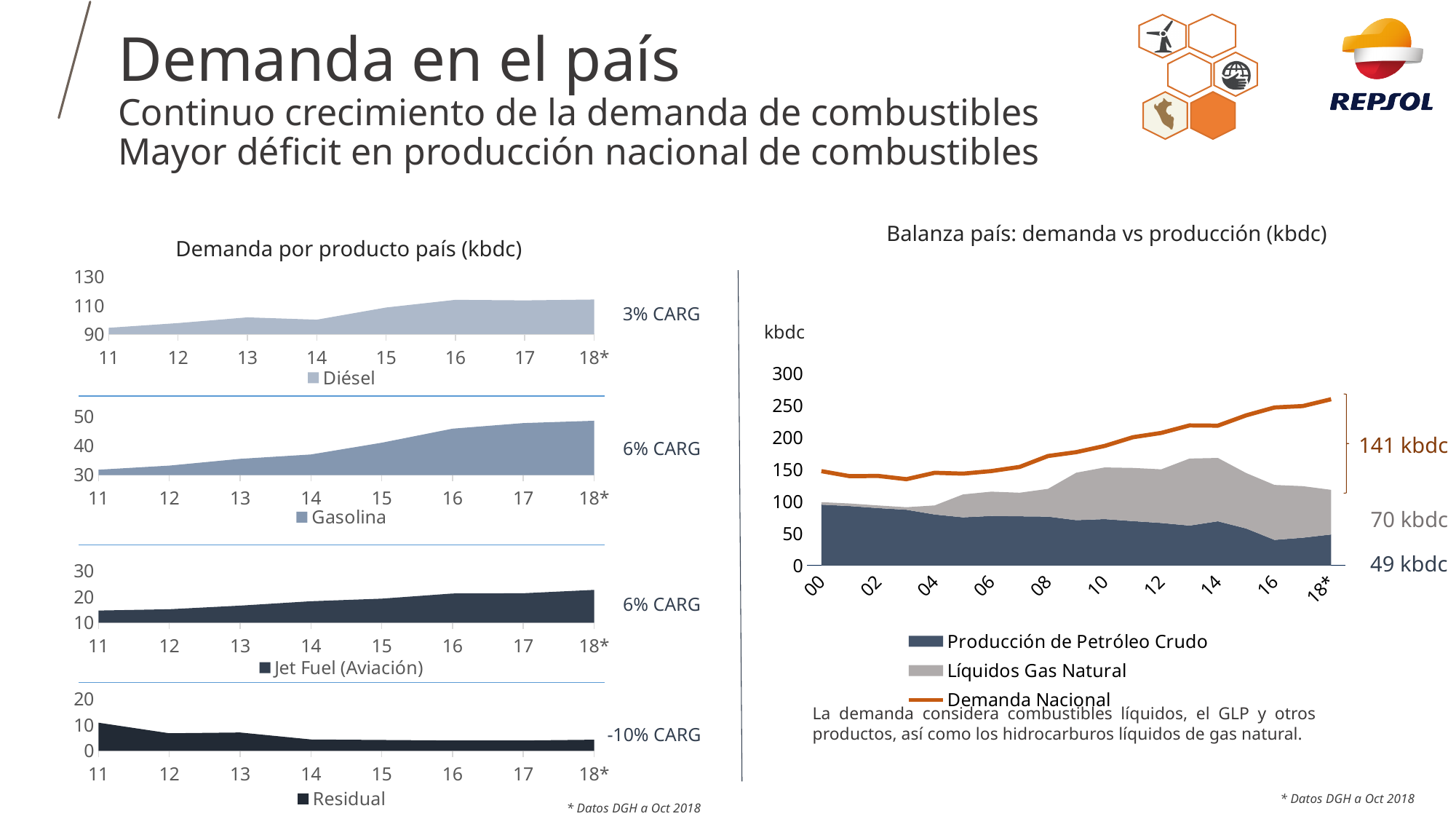
In the 'Balanza país: demanda vs producción (kbdc)' chart, how many series does the legend list? 3 What kind of chart is the Diésel chart on the left side of the slide? area chart In the Residual chart on the left, do the values rise or fall from 11 to 18*? fall What CARG is shown next to the Residual chart on the left? -10% CARG In the Jet Fuel (Aviación) chart on the left, do the values rise or fall from 11 to 18*? rise In the 'Balanza país: demanda vs producción (kbdc)' chart, which series is drawn as a line rather than a filled area? Demanda Nacional In the Diésel chart on the left, do the values rise or fall from 11 to 18*? rise In the 'Balanza país: demanda vs producción (kbdc)' chart, what value is labelled for Producción de Petróleo Crudo at 18*? 49 kbdc What CARG is shown next to the Gasolina chart on the left? 6% CARG In the 'Balanza país: demanda vs producción (kbdc)' chart, what value is labelled for Líquidos Gas Natural at 18*? 70 kbdc In the 'Balanza país: demanda vs producción (kbdc)' chart, is the value of Demanda Nacional at 18* greater or less than 200? greater In the Diésel chart on the left, how many years are shown on the x axis? 8